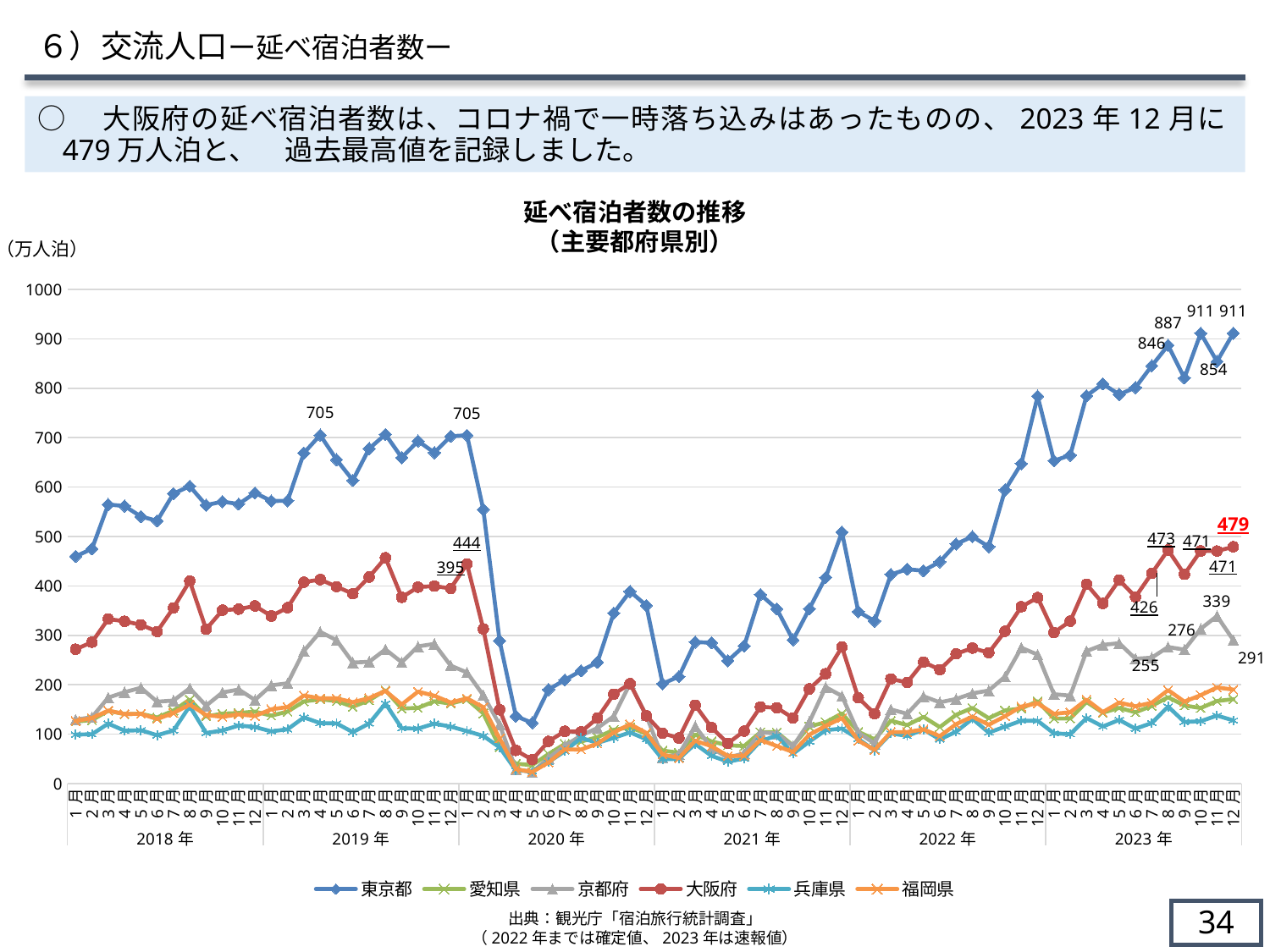
What is the value for 大阪府 in 2023年12月? 479 How many series does the legend list? 6 What is the value for 京都府 in 2023年12月? 291 What kind of chart is shown on the slide? line chart Which is larger in 2023年12月, 大阪府 or 京都府? 大阪府 Is the value for 大阪府 in 2020年5月 greater or less than 100? less Which prefecture has the highest value in 2023年12月? 東京都 What is the difference between 東京都 and 大阪府 in 2023年12月? 432 Which prefecture has the lowest value in 2023年12月? 兵庫県 What unit is shown for the vertical axis? 万人泊 What is the value for 東京都 in 2023年12月? 911 What is the value for 大阪府 in 2020年1月? 444